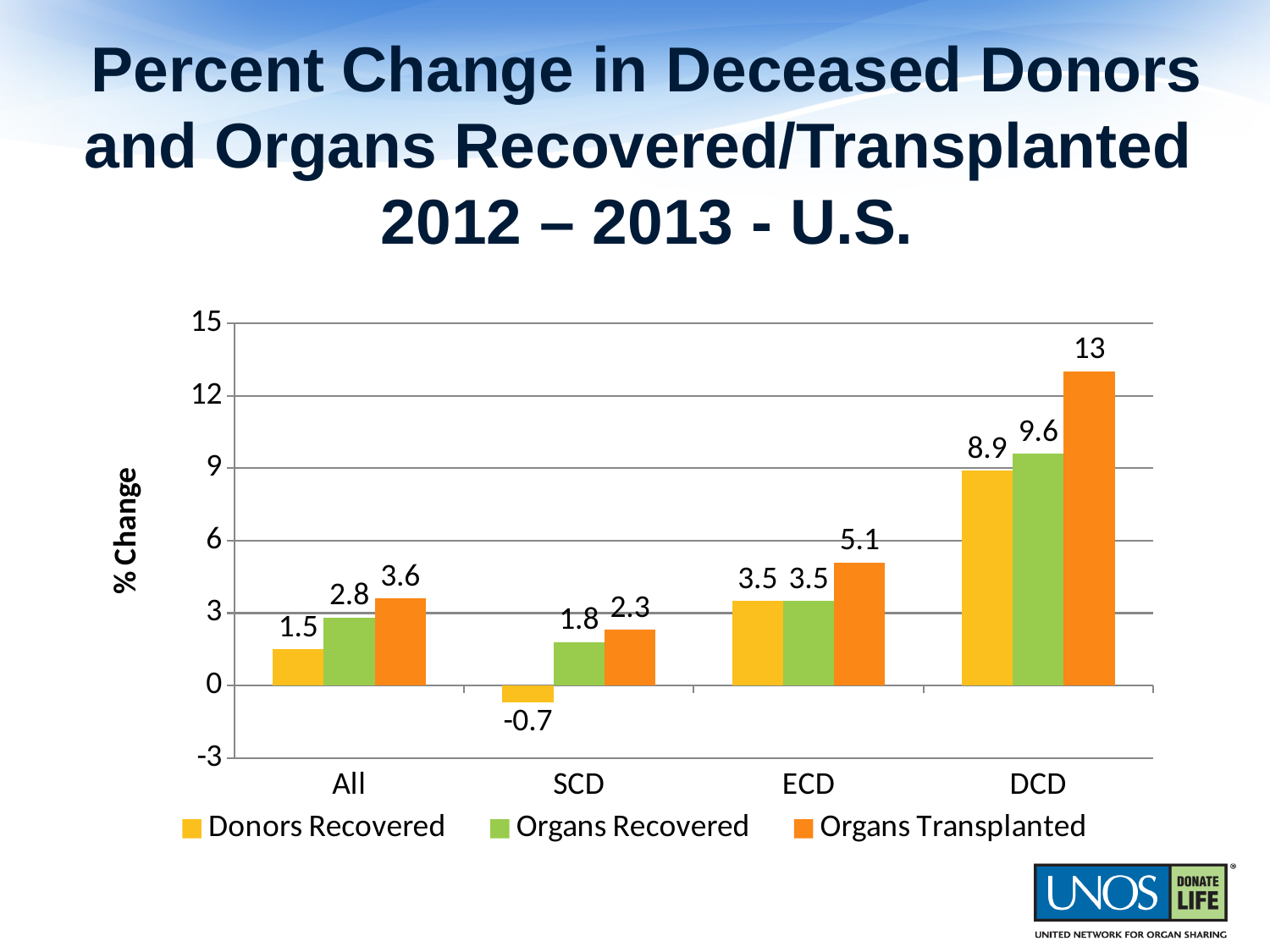
What is the value for Organs Recovered in the All category? 2.8 Is the value for Organs Recovered in the DCD category greater or less than 9? greater What is the value for Organs Transplanted in the DCD category? 13 What is the difference between Organs Transplanted and Donors Recovered in the DCD category? 4.1 What is the value for Donors Recovered in the SCD category? -0.7 Which category has the highest value for Organs Transplanted? DCD What kind of chart is shown on the slide? Bar chart What is the label of the y axis? % Change Which is larger in the ECD category: Organs Transplanted or Organs Recovered? Organs Transplanted How many categories are shown on the x axis? 4 How many series does the legend list? 3 Which category has the lowest value for Donors Recovered? SCD